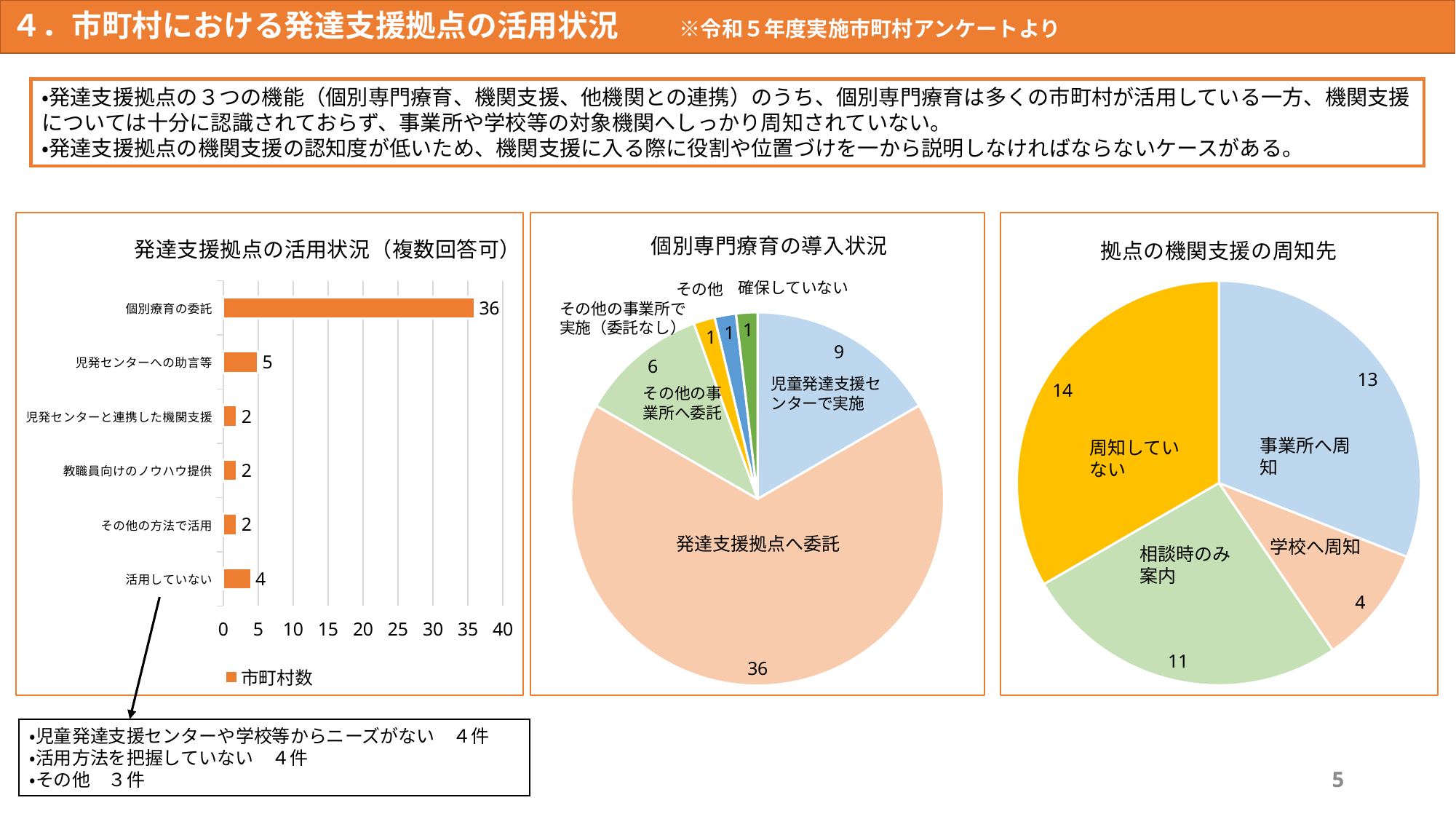
What type of chart is 発達支援拠点の活用状況（複数回答可）? bar chart In the bar chart 発達支援拠点の活用状況（複数回答可）, what is the difference between 個別療育の委託 and 児発センターへの助言等? 31 In the pie chart 拠点の機関支援の周知先, which category has the lowest value? 学校へ周知 In the pie chart 個別専門療育の導入状況, which is larger, その他の事業所へ委託 or 児童発達支援センターで実施? 児童発達支援センターで実施 In the bar chart 発達支援拠点の活用状況（複数回答可）, which category has the highest value? 個別療育の委託 In the bar chart 発達支援拠点の活用状況（複数回答可）, how many categories are shown? 6 In the pie chart 拠点の機関支援の周知先, what is the value for 相談時のみ案内? 11 In the bar chart 発達支援拠点の活用状況（複数回答可）, what is the value for 個別療育の委託? 36 In the bar chart 発達支援拠点の活用状況（複数回答可）, what is the value for 活用していない? 4 In the pie chart 拠点の機関支援の周知先, what is the difference between 周知していない and 事業所へ周知? 1 In the pie chart 個別専門療育の導入状況, what is the value for 児童発達支援センターで実施? 9 In the pie chart 個別専門療育の導入状況, what is the value for 発達支援拠点へ委託? 36